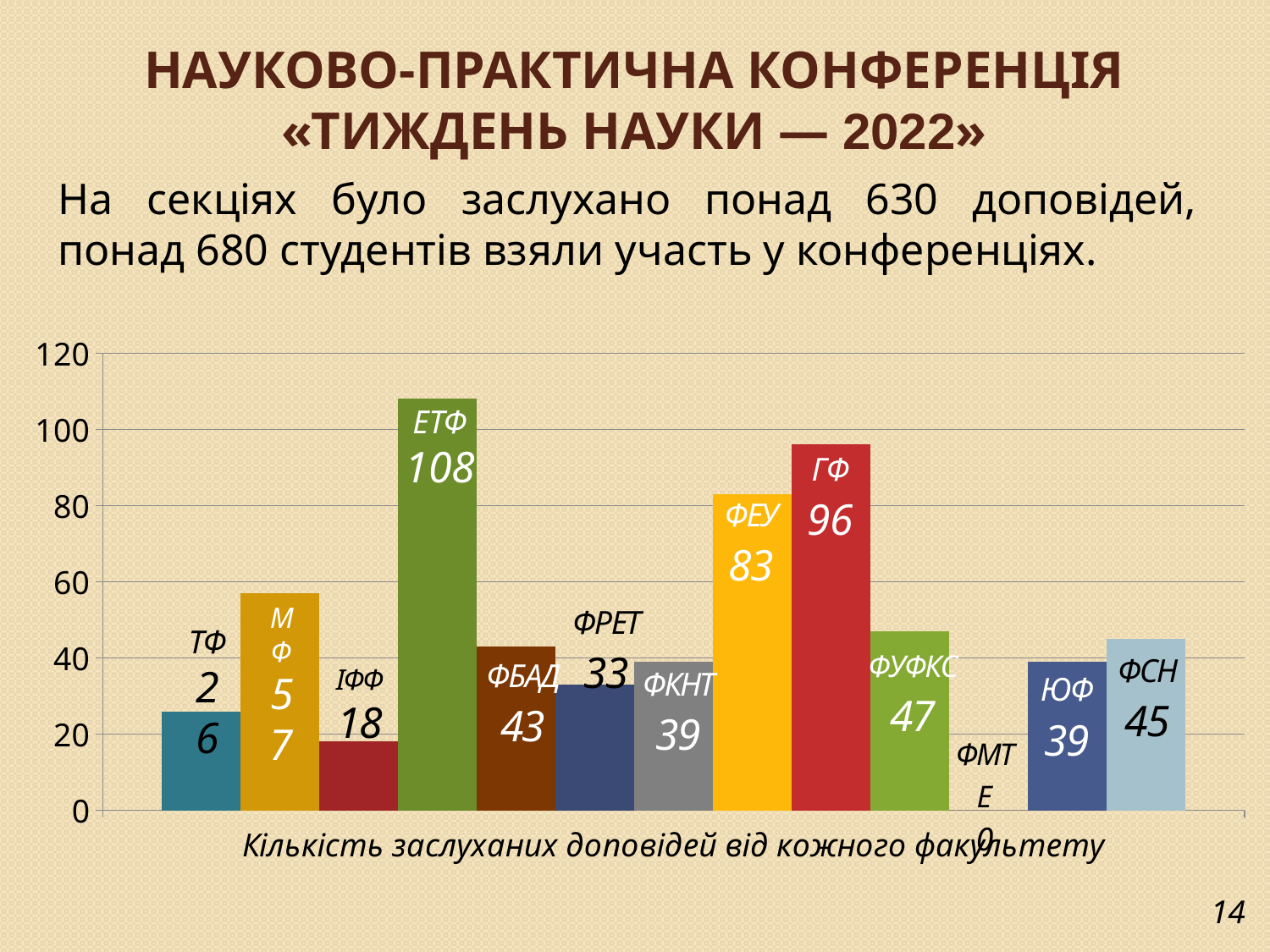
Which is larger, the value for ФБАД or the value for ФРЕТ? ФБАД What type of chart is shown on the slide? bar chart What is the value for ІФФ? 18 What is the value for ФСН? 45 Which faculty has the highest number of reports? ЕТФ What is the value for ЕТФ? 108 What is the value for ГФ? 96 What is the value for ФЕУ? 83 What is the axis title shown below the bars? Кількість заслуханих доповідей від кожного факультету What is the difference between the values for ЕТФ and ГФ? 12 Is the value for ФУФКС greater or less than 40? greater Which faculty has the lowest number of reports? ФМТЕ